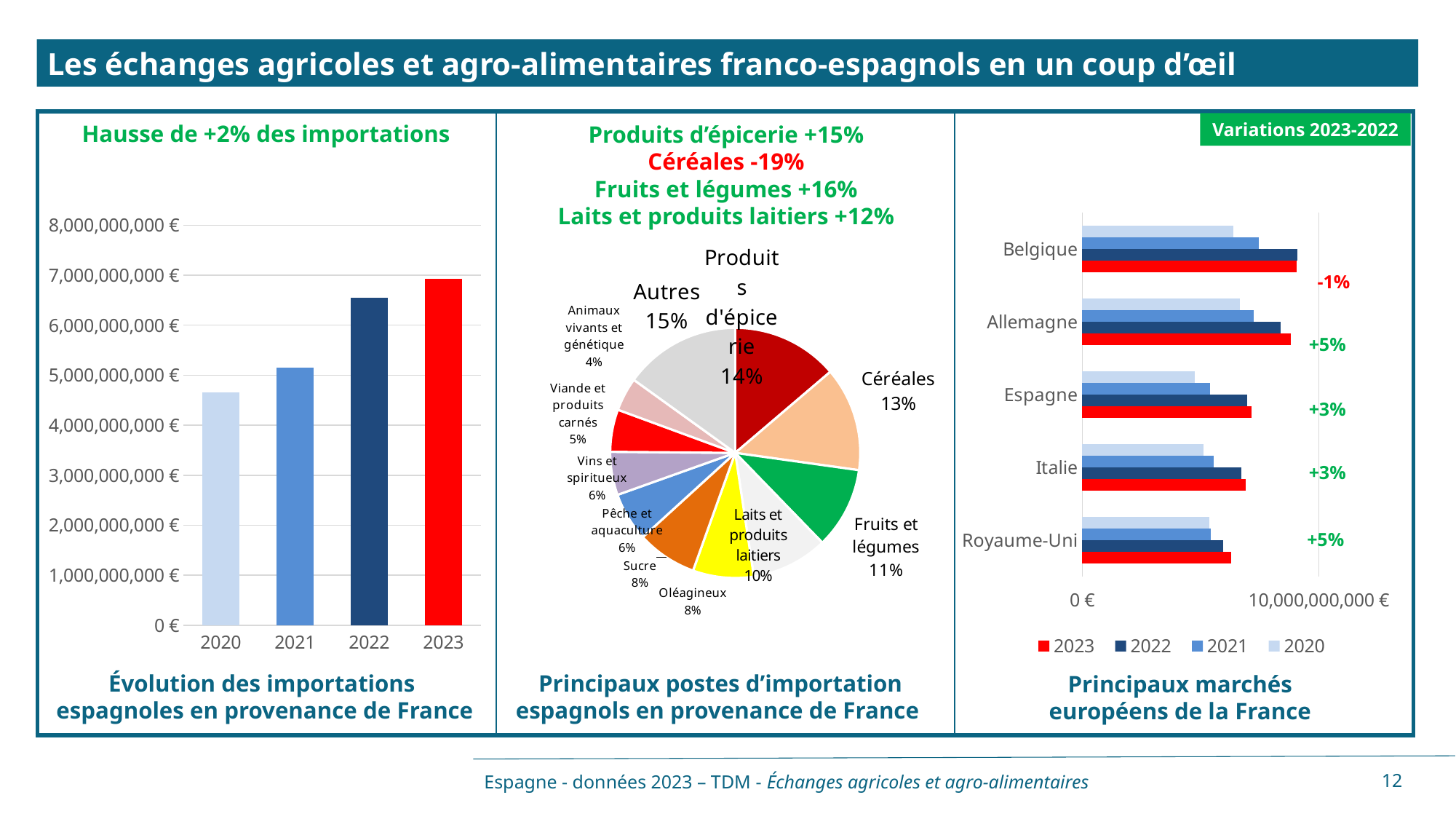
In the right chart 'Principaux marchés européens de la France', which is larger for 2023: Belgique or Royaume-Uni? Belgique In the left chart 'Évolution des importations espagnoles en provenance de France', do the values rise or fall from 2020 to 2023? rise In the right chart 'Principaux marchés européens de la France', how many series does the legend list? 4 In the left chart 'Évolution des importations espagnoles en provenance de France', what kind of chart is used? bar chart In the middle pie chart 'Principaux postes d'importation espagnols en provenance de France', which slice is the largest? Autres In the right chart 'Principaux marchés européens de la France', how many countries are shown? 5 In the middle pie chart 'Principaux postes d'importation espagnols en provenance de France', how many slices are there? 11 In the middle pie chart 'Principaux postes d'importation espagnols en provenance de France', what share does Céréales have? 13% In the left chart 'Évolution des importations espagnoles en provenance de France', which year has the highest value? 2023 In the left chart 'Évolution des importations espagnoles en provenance de France', is the value for 2020 greater or less than 5,000,000,000 €? less In the middle pie chart 'Principaux postes d'importation espagnols en provenance de France', which slice is the smallest? Animaux vivants et génétique In the middle pie chart 'Principaux postes d'importation espagnols en provenance de France', what is the difference in percentage points between Produits d'épicerie and Laits et produits laitiers? 4